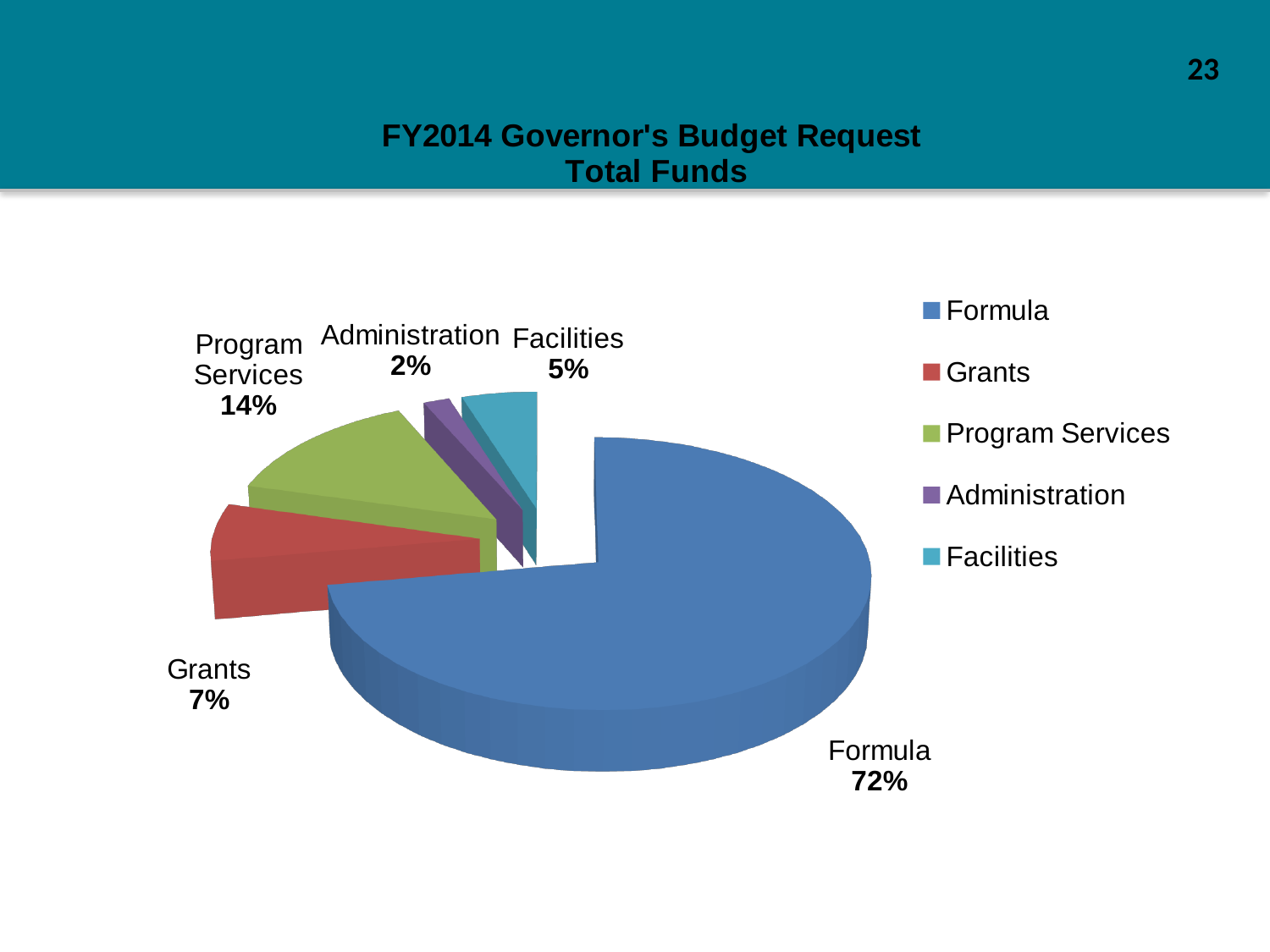
What percentage is shown for Program Services? 14% Which category has the smallest slice of the pie? Administration What colour is the Program Services slice? Green What is the difference in percentage points between Program Services and Grants? 7 Which is larger, the share for Grants or the share for Facilities? Grants What percentage is shown for Facilities? 5% How many categories are shown in the pie chart? 5 What share of the pie does Formula account for? 72% What kind of chart is shown on the slide? Pie chart What percentage is shown for Grants? 7% Which category has the largest slice of the pie? Formula What is the title of the chart? FY2014 Governor's Budget Request Total Funds